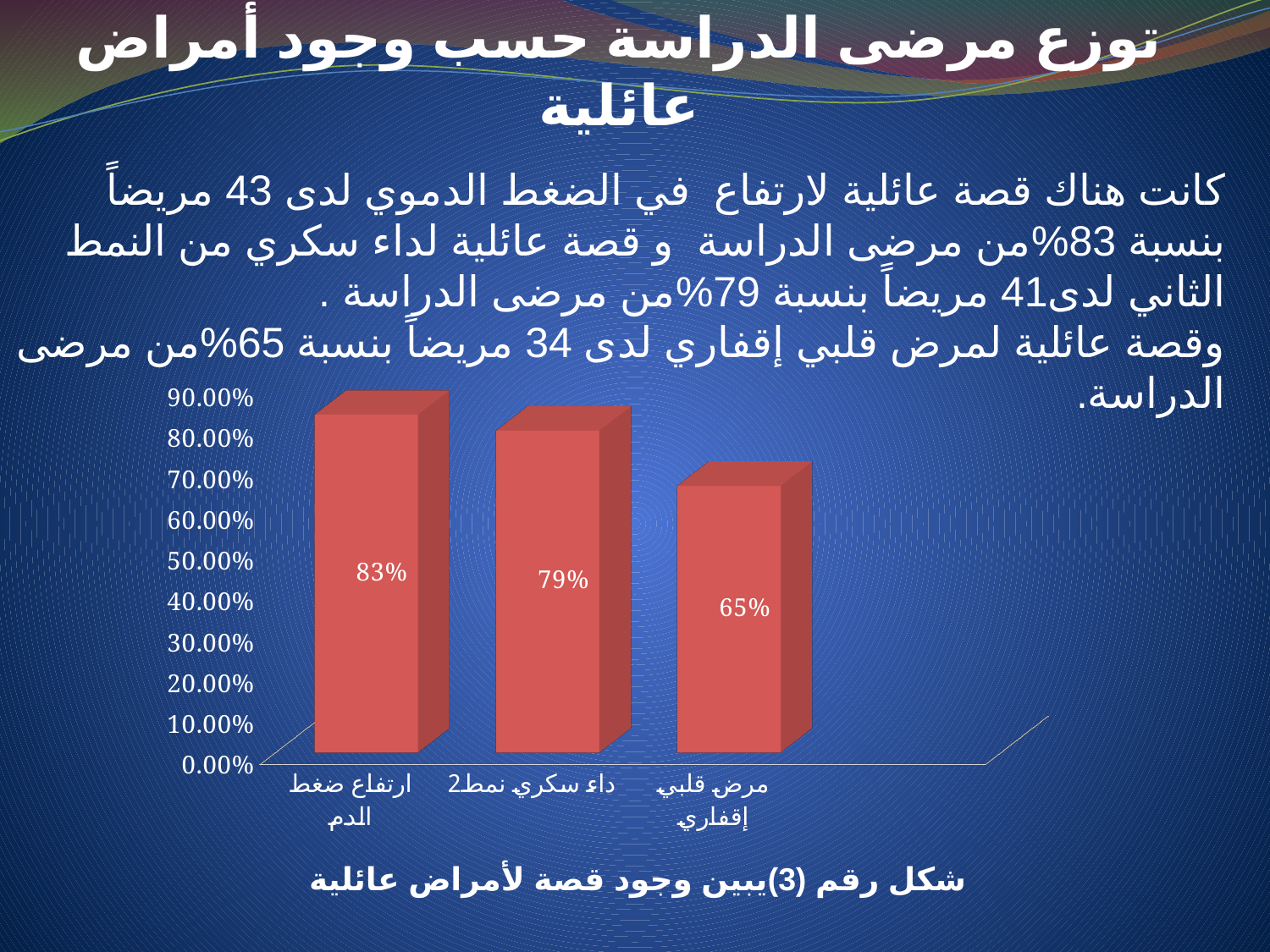
What is the difference between the values for داء سكري نمط2 and مرض قلبي إقفاري? 14 percentage points What kind of chart is shown on the slide? bar chart How many categories are shown in the chart? 3 Which category has the lowest value? مرض قلبي إقفاري Which category has the highest value? ارتفاع ضغط الدم Is the value for مرض قلبي إقفاري greater or less than 70.00%? less What is the difference between the values for ارتفاع ضغط الدم and مرض قلبي إقفاري? 18 percentage points What is the value for داء سكري نمط2? 79% What is the value for ارتفاع ضغط الدم? 83% What is the value for مرض قلبي إقفاري? 65% Do the values rise or fall from left to right along the x axis? fall Which is larger, the value for داء سكري نمط2 or the value for مرض قلبي إقفاري? داء سكري نمط2